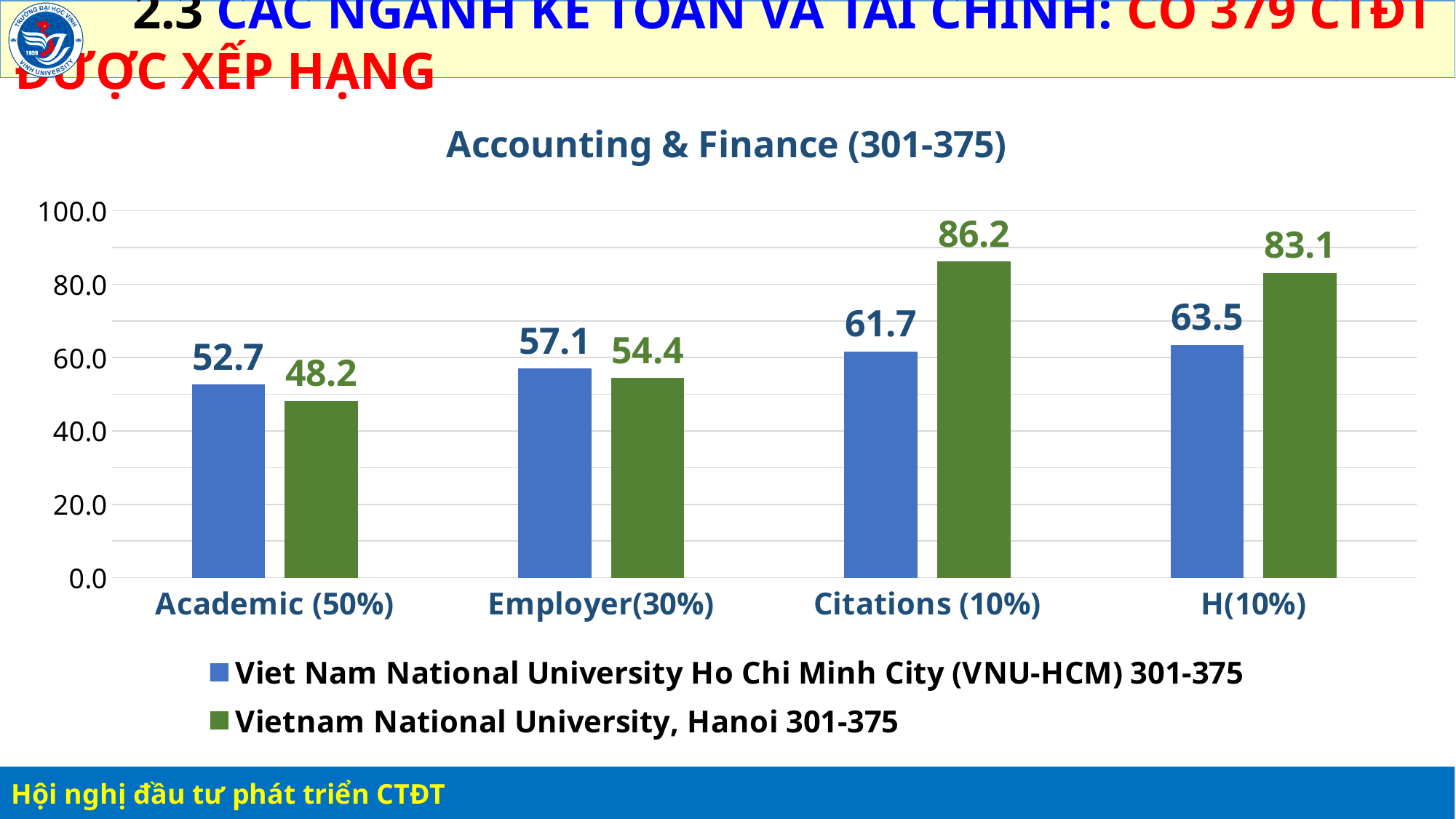
How many series does the legend list? 2 What is the difference between the two universities' values in the Citations (10%) category? 24.5 What is the value for Vietnam National University, Hanoi in the H(10%) category? 83.1 How many categories are shown on the x axis? 4 In which category does Vietnam National University, Hanoi have its highest value? Citations (10%) What type of chart is shown on the slide? Bar chart What is the value for Viet Nam National University Ho Chi Minh City (VNU-HCM) in the Academic (50%) category? 52.7 In which category does Viet Nam National University Ho Chi Minh City (VNU-HCM) have its lowest value? Academic (50%) What is the value for Viet Nam National University Ho Chi Minh City (VNU-HCM) in the Employer(30%) category? 57.1 Is the value for Vietnam National University, Hanoi in the Academic (50%) category greater or less than 60.0? less What is the value for Vietnam National University, Hanoi in the Citations (10%) category? 86.2 Which university has the larger value in the Employer(30%) category? Viet Nam National University Ho Chi Minh City (VNU-HCM)